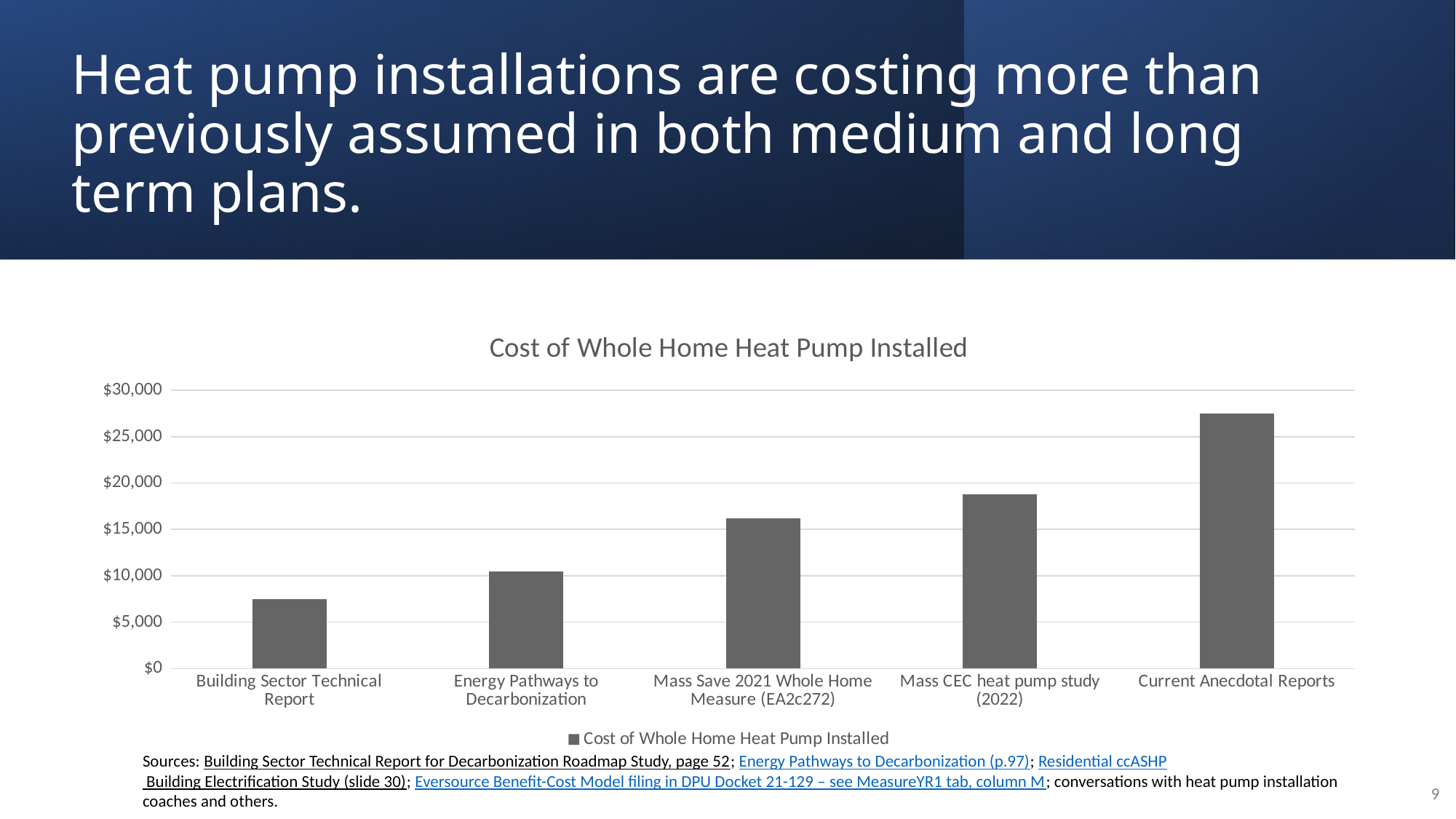
How many series does the chart legend list? 1 Do the values rise or fall from left to right across the categories? rise How many categories are shown on the x axis of the chart? 5 Is the value for Current Anecdotal Reports greater or less than $25,000? greater What is the title of the chart? Cost of Whole Home Heat Pump Installed Which category has the highest cost of whole home heat pump installed? Current Anecdotal Reports Is the value for Building Sector Technical Report greater or less than $10,000? less Which is larger, the value for Energy Pathways to Decarbonization or the value for Mass Save 2021 Whole Home Measure (EA2c272)? Mass Save 2021 Whole Home Measure (EA2c272) What type of chart is shown on the slide? bar chart Is the value for Mass Save 2021 Whole Home Measure (EA2c272) greater or less than $15,000? greater Which category has the lowest cost of whole home heat pump installed? Building Sector Technical Report